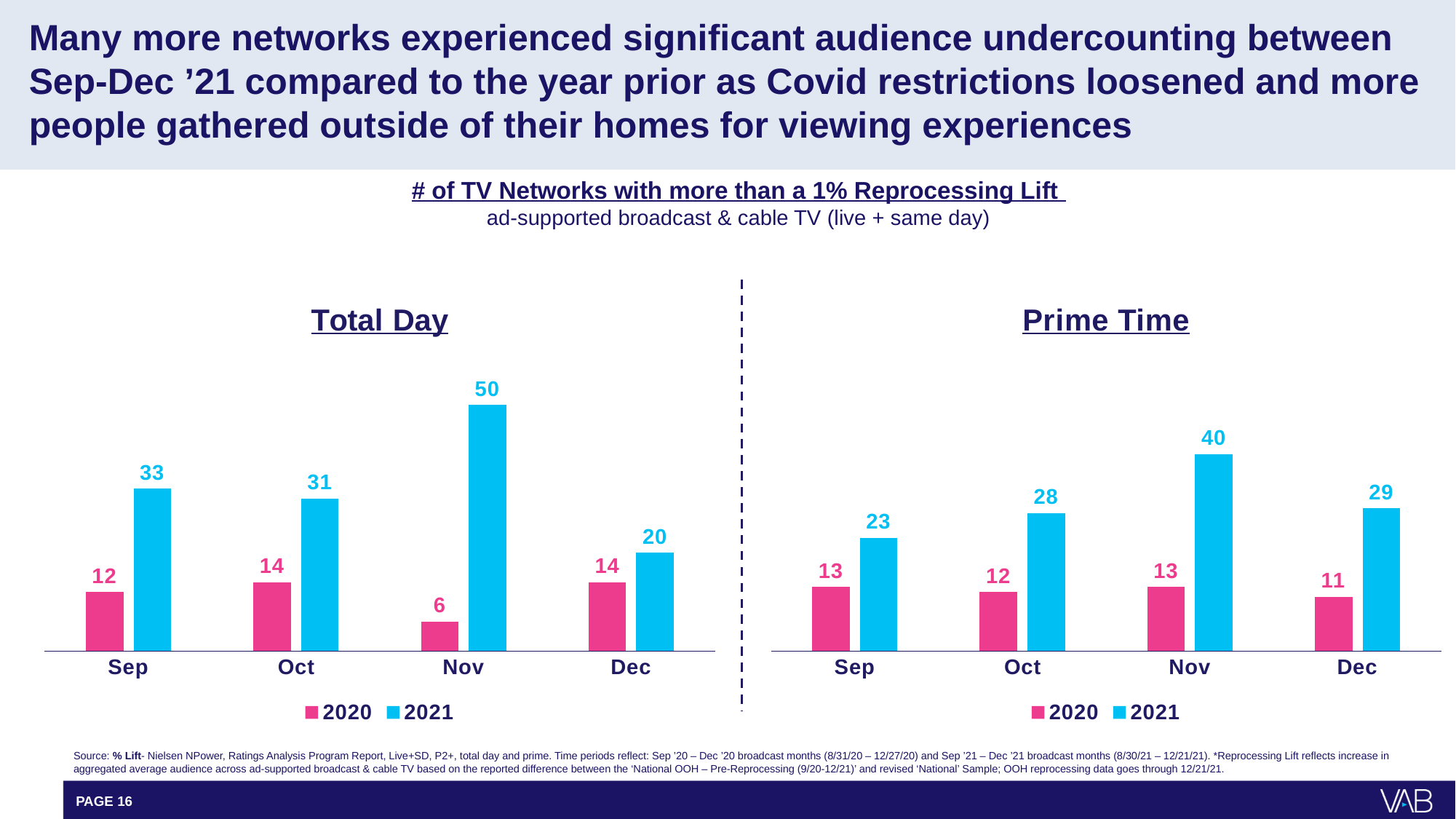
In the Prime Time chart, which month has the highest value for 2021? Nov In the Total Day chart, what is the value for 2021 in Nov? 50 In the Total Day chart, which month has the lowest value for 2020? Nov What kind of chart is the Total Day chart? Bar chart In the Prime Time chart, what colour are the 2021 bars? Blue In the Prime Time chart, what is the difference between the 2021 values for Nov and Dec? 11 How many months are shown on the x axis of the Total Day chart? 4 In the Total Day chart, what is the difference between the 2021 and 2020 values in Nov? 44 In the Prime Time chart, which is larger: the 2020 value for Sep or the 2020 value for Oct? Sep In the Prime Time chart, what is the value for 2020 in Dec? 11 In the Total Day chart, which is larger: the 2021 value for Sep or the 2021 value for Oct? Sep How many series does the legend of the Prime Time chart list? 2